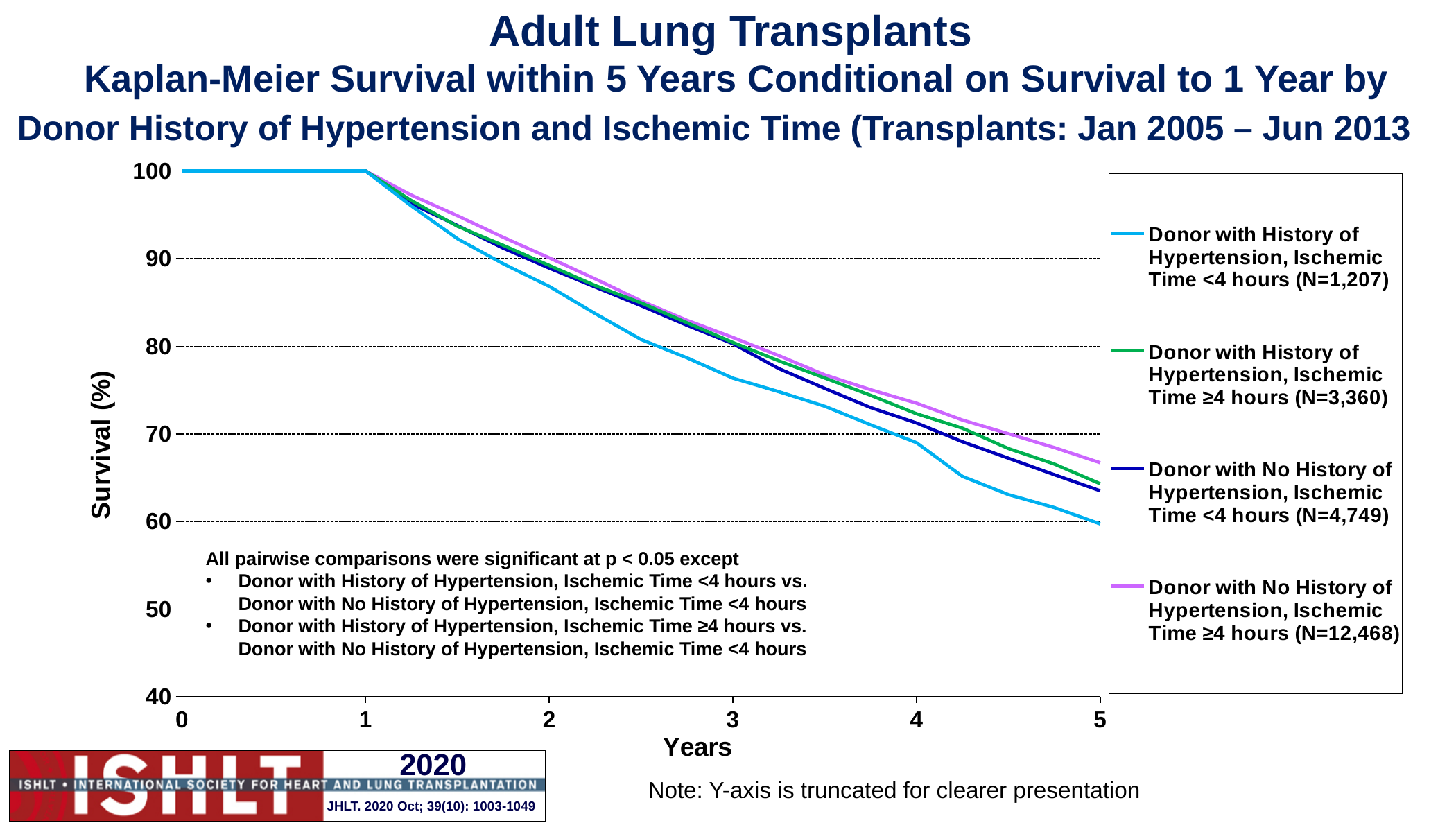
At year 5, which is larger: the survival for Donor with No History of Hypertension, Ischemic Time ≥4 hours or for Donor with History of Hypertension, Ischemic Time <4 hours? Donor with No History of Hypertension, Ischemic Time ≥4 hours Do the survival curves rise or fall as years increase beyond year 1? fall What is the survival (%) value for all four groups at year 1? 100 Which group has the highest survival at year 5? Donor with No History of Hypertension, Ischemic Time ≥4 hours (N=12,468) How many series does the legend list? 4 Is the survival value for Donor with No History of Hypertension, Ischemic Time ≥4 hours at year 5 greater or less than 70? less Which group has the lowest survival at year 5? Donor with History of Hypertension, Ischemic Time <4 hours (N=1,207) Is the survival value for Donor with No History of Hypertension, Ischemic Time ≥4 hours at year 4 greater or less than 70? greater What is the label of the y-axis? Survival (%) Is the survival value for Donor with History of Hypertension, Ischemic Time <4 hours at year 3 greater or less than 80? less What is the N for the Donor with No History of Hypertension, Ischemic Time <4 hours group in the legend? N=4,749 What kind of chart is shown on the slide? line chart